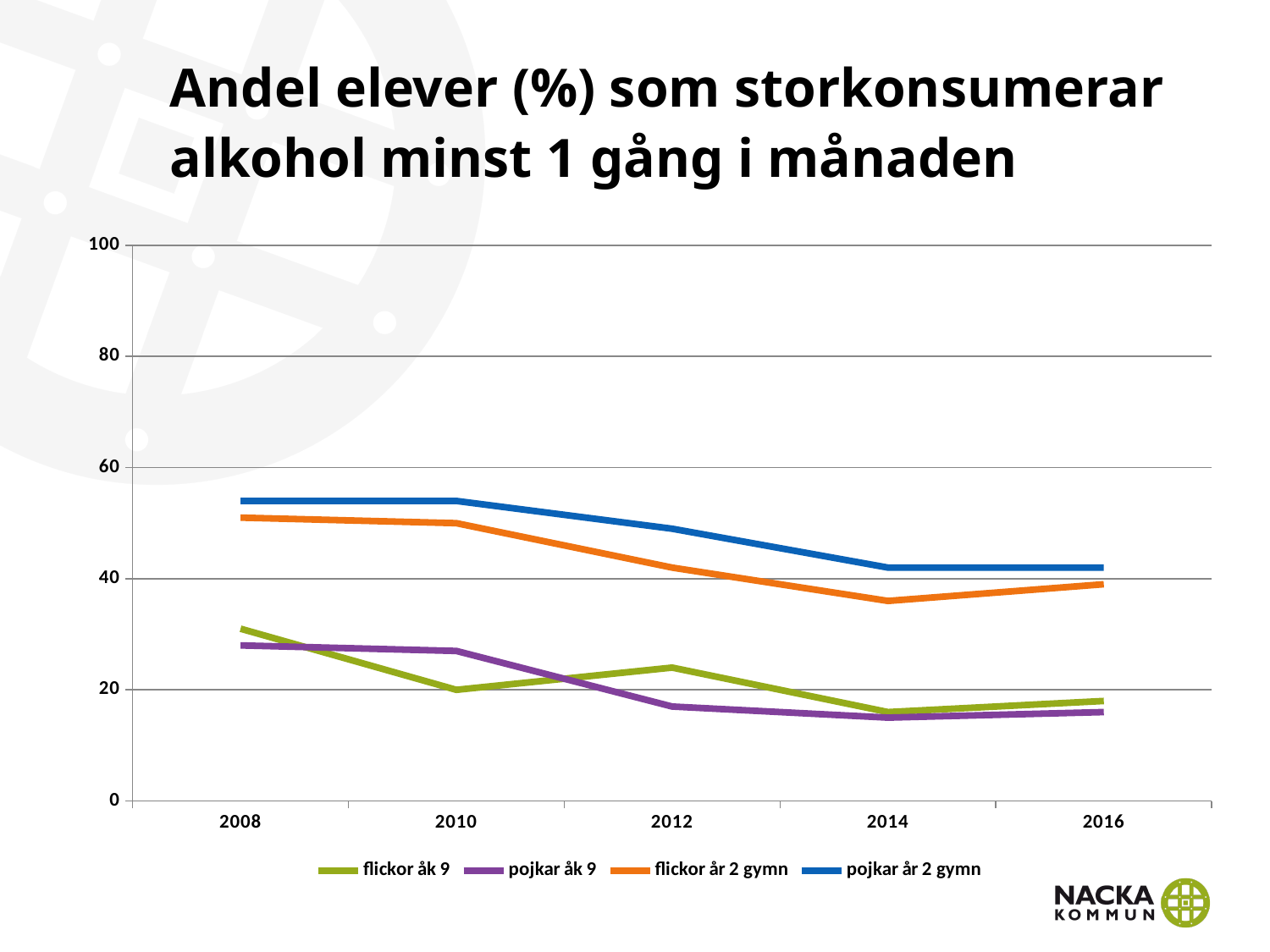
Is the value for flickor åk 9 in 2008 greater or less than 20? greater In 2016, which is larger: the value for flickor år 2 gymn or the value for pojkar åk 9? flickor år 2 gymn How many years are shown on the x axis? 5 Does the value for pojkar år 2 gymn rise or fall from 2008 to 2016? fall Which series has the highest value in 2008? pojkar år 2 gymn Is the value for flickor åk 9 in 2010 greater or less than 40? less Is the value for pojkar åk 9 in 2014 greater or less than 20? less What kind of chart is shown on the slide? line chart What is the title of the chart? Andel elever (%) som storkonsumerar alkohol minst 1 gång i månaden How many series does the legend list? 4 Which series has the lowest value in 2010? flickor åk 9